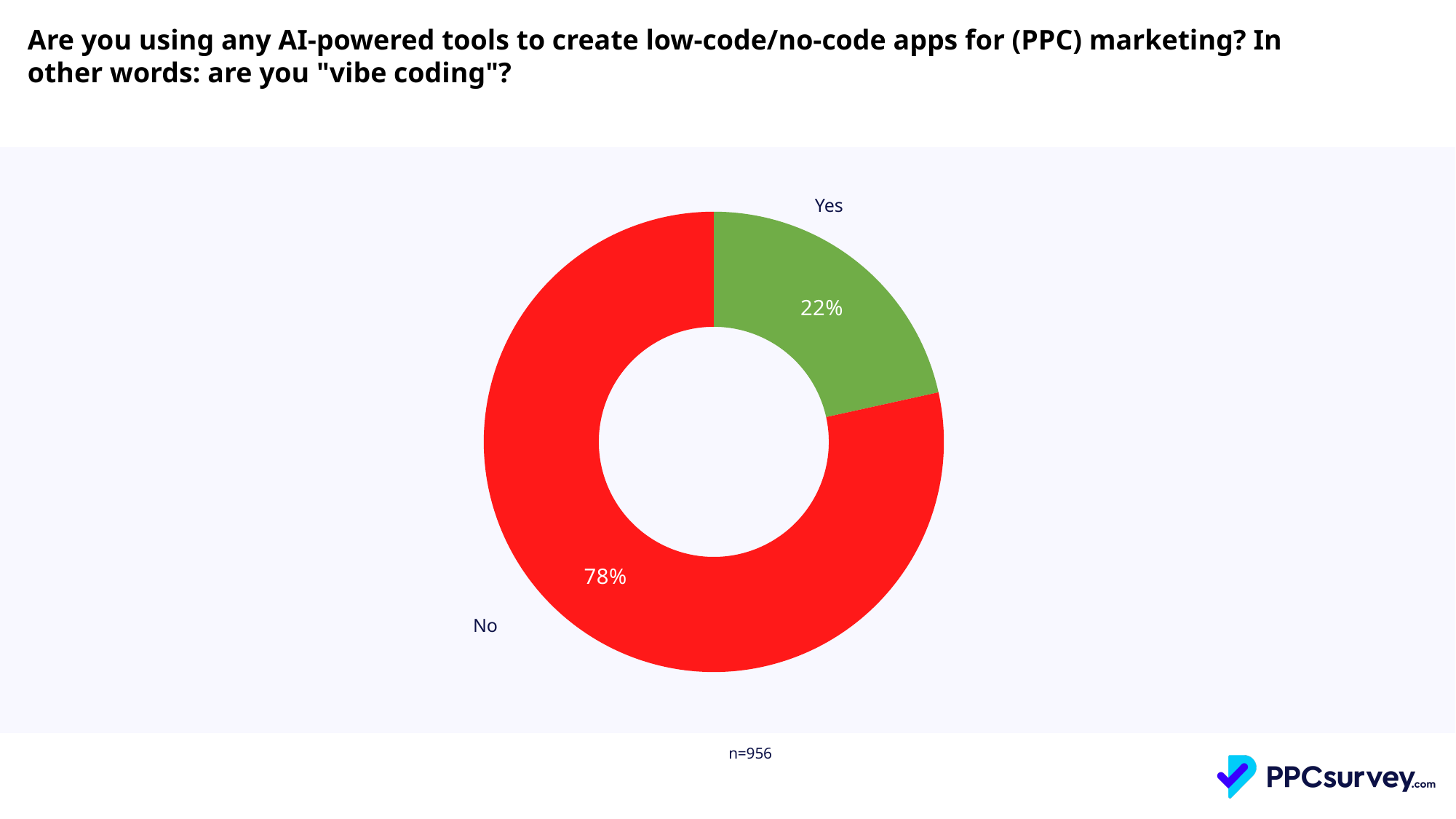
What percentage of respondents answered "Yes"? 22% Which response has the largest share of the chart? No How many categories are shown in the chart? 2 What kind of chart is shown on the slide? Pie chart (donut) What is the sample size (n) shown below the chart? n=956 What percentage of respondents answered "No"? 78% What colour is the "No" slice? Red Which is larger, the share for "Yes" or the share for "No"? No Which response has the smallest share of the chart? Yes What share of the pie does the "Yes" slice represent? 22% What is the difference in percentage points between the "No" and "Yes" shares? 56